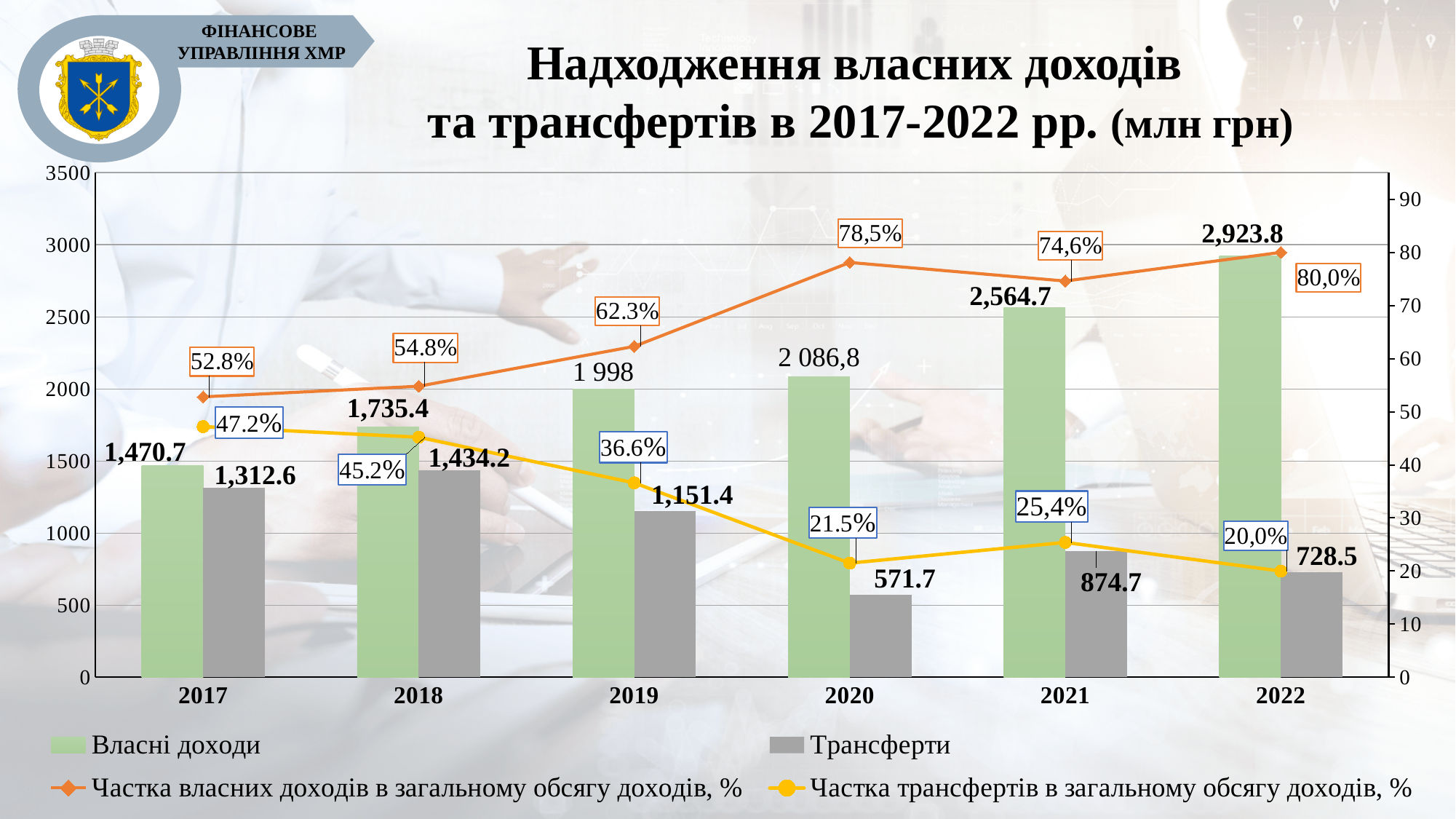
What is the Частка власних доходів в загальному обсягу доходів, % for 2019? 62.3% Which is larger in 2018: Власні доходи or Трансферти? Власні доходи What kind of chart is this? Combined bar and line chart In which year is Трансферти the lowest? 2020 What is the Частка трансфертів в загальному обсягу доходів, % for 2021? 25,4% How many years are shown on the x axis? 6 What is the difference between Власні доходи and Трансферти in 2021? 1,690.0 In which year is Власні доходи the highest? 2022 How many series does the legend list? 4 Does the Частка трансфертів в загальному обсягу доходів, % line generally rise or fall from 2017 to 2022? Fall What is the value of Трансферти for 2020? 571.7 What is the value of Власні доходи for 2022? 2,923.8